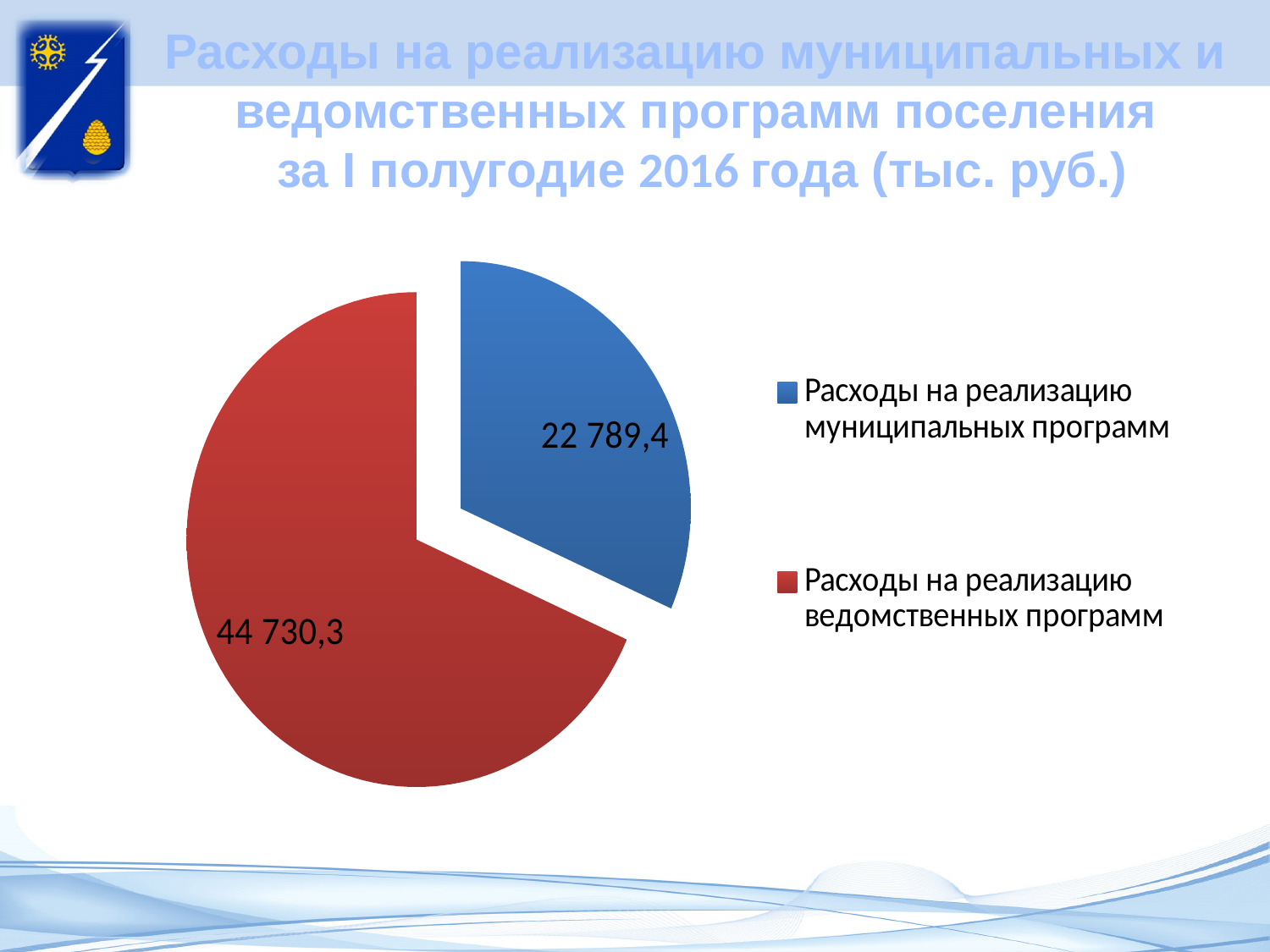
Which is larger: expenses on municipal programs or expenses on departmental programs? Расходы на реализацию ведомственных программ Which category has the smallest slice of the pie? Расходы на реализацию муниципальных программ How many entries does the legend list? 2 What colour is the slice for «Расходы на реализацию муниципальных программ»? Blue What is the difference between the value for departmental programs and the value for municipal programs? 21 940,9 What is the total of the two values shown in the pie chart? 67 519,7 Which category has the largest slice of the pie? Расходы на реализацию ведомственных программ What type of chart is shown on the slide? Pie chart What is the value for «Расходы на реализацию ведомственных программ»? 44 730,3 How many slices does the pie chart have? 2 What is the value for «Расходы на реализацию муниципальных программ»? 22 789,4